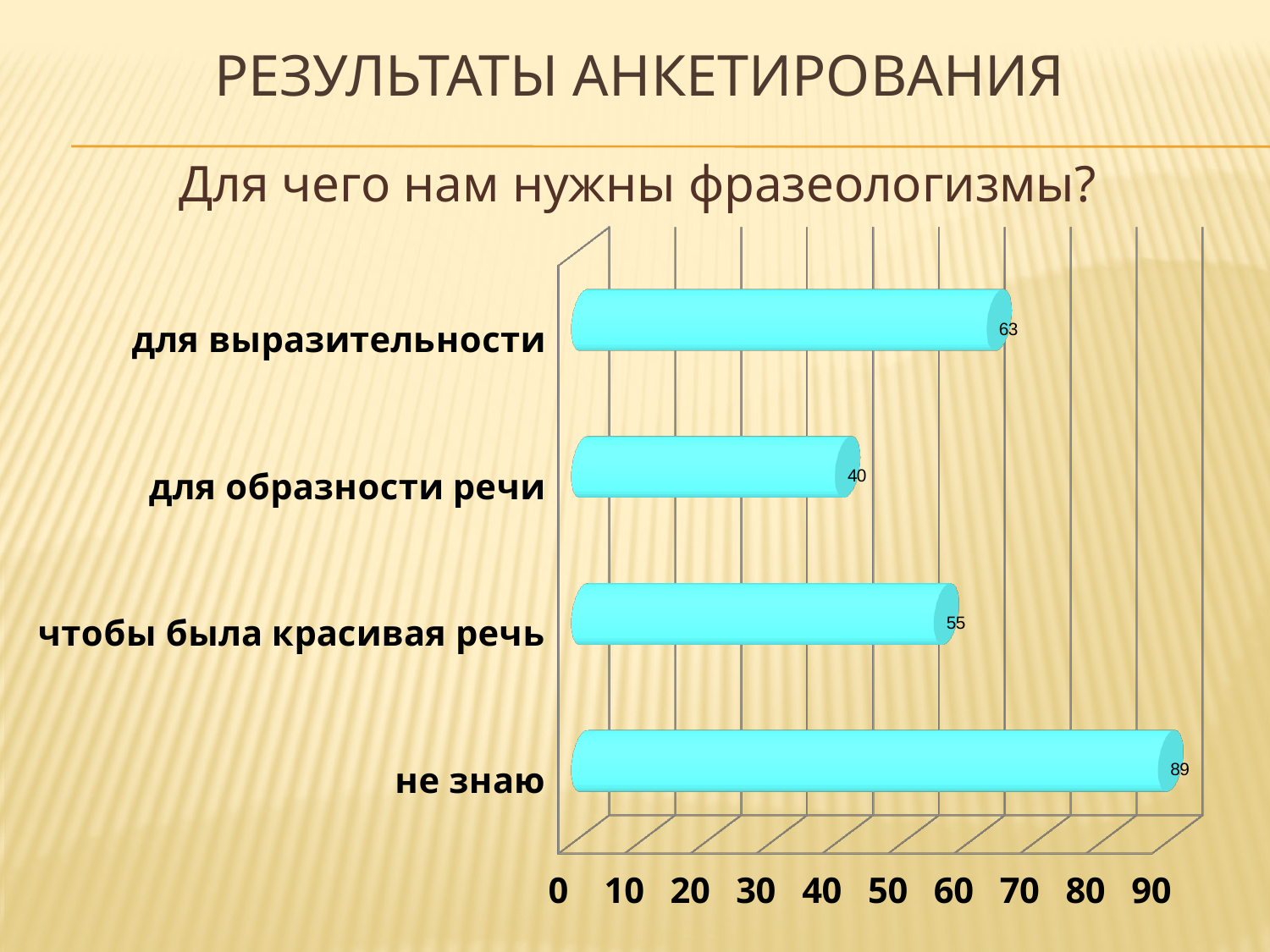
Which is larger: the value for "для выразительности" or the value for "чтобы была красивая речь"? для выразительности How many categories are shown in the chart? 4 What kind of chart is shown on the slide? bar chart What is the difference between the values for "не знаю" and "для выразительности"? 26 What is the value for "чтобы была красивая речь"? 55 Which category has the lowest value? для образности речи What is the value for "для выразительности"? 63 What is the difference between the values for "чтобы была красивая речь" and "для образности речи"? 15 What is the value for "для образности речи"? 40 What is the value for "не знаю"? 89 Which category has the highest value? не знаю What question is the chart titled with? Для чего нам нужны фразеологизмы?